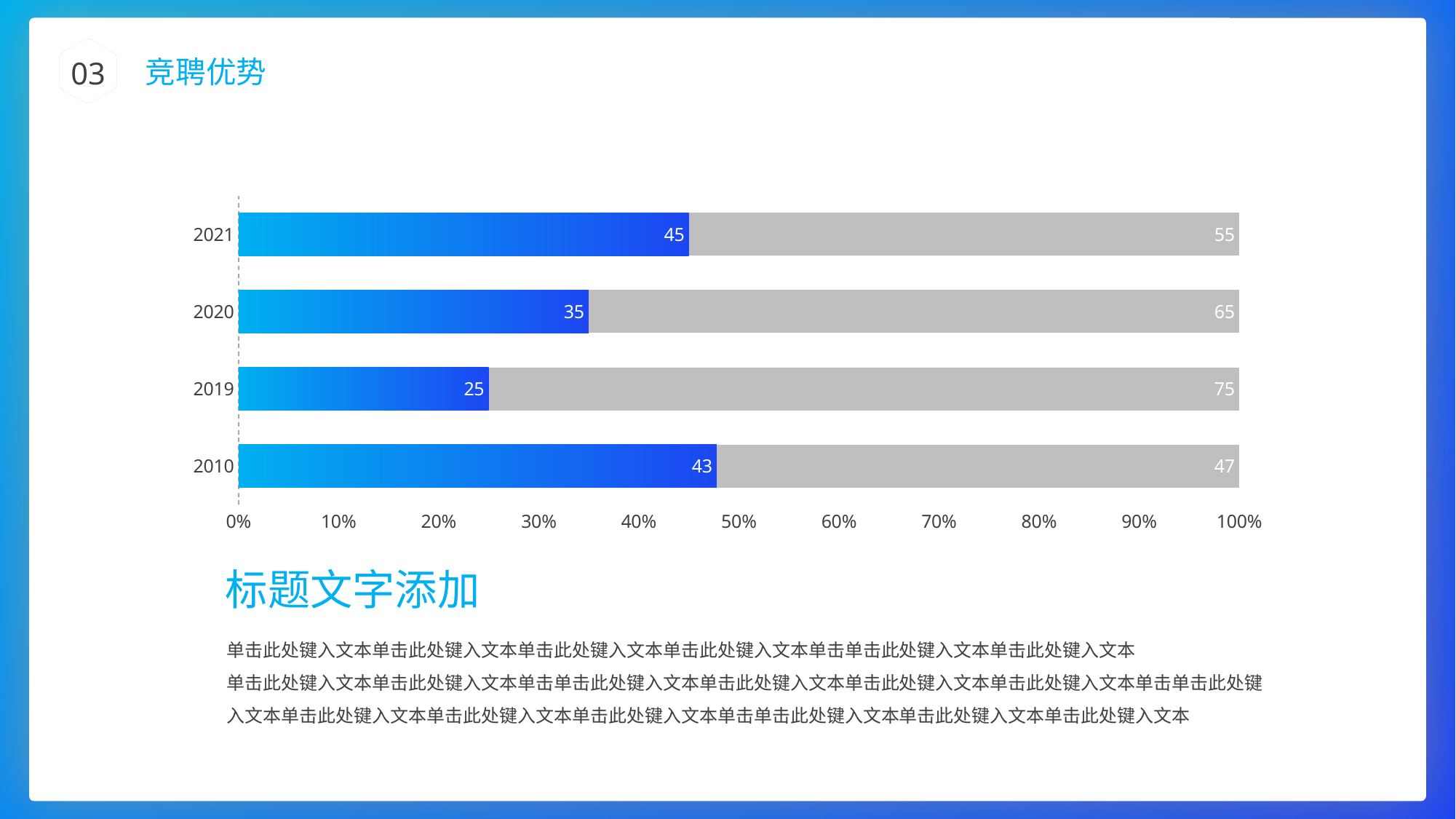
How many categories (years) are shown on the chart? 4 What is the value of the gray segment for 2019? 75 What is the value of the gray segment for 2020? 65 What is the value of the blue segment for 2010? 43 Which year has the highest blue segment value? 2021 What is the total of the two labelled segments in the 2021 bar? 100 Which year has the larger blue segment value, 2020 or 2010? 2010 Which year has the lowest blue segment value? 2019 What is the value of the blue segment for 2021? 45 What is the difference between the blue segment values for 2021 and 2019? 20 Which year has the highest gray segment value? 2019 What kind of chart is shown on the slide? bar chart